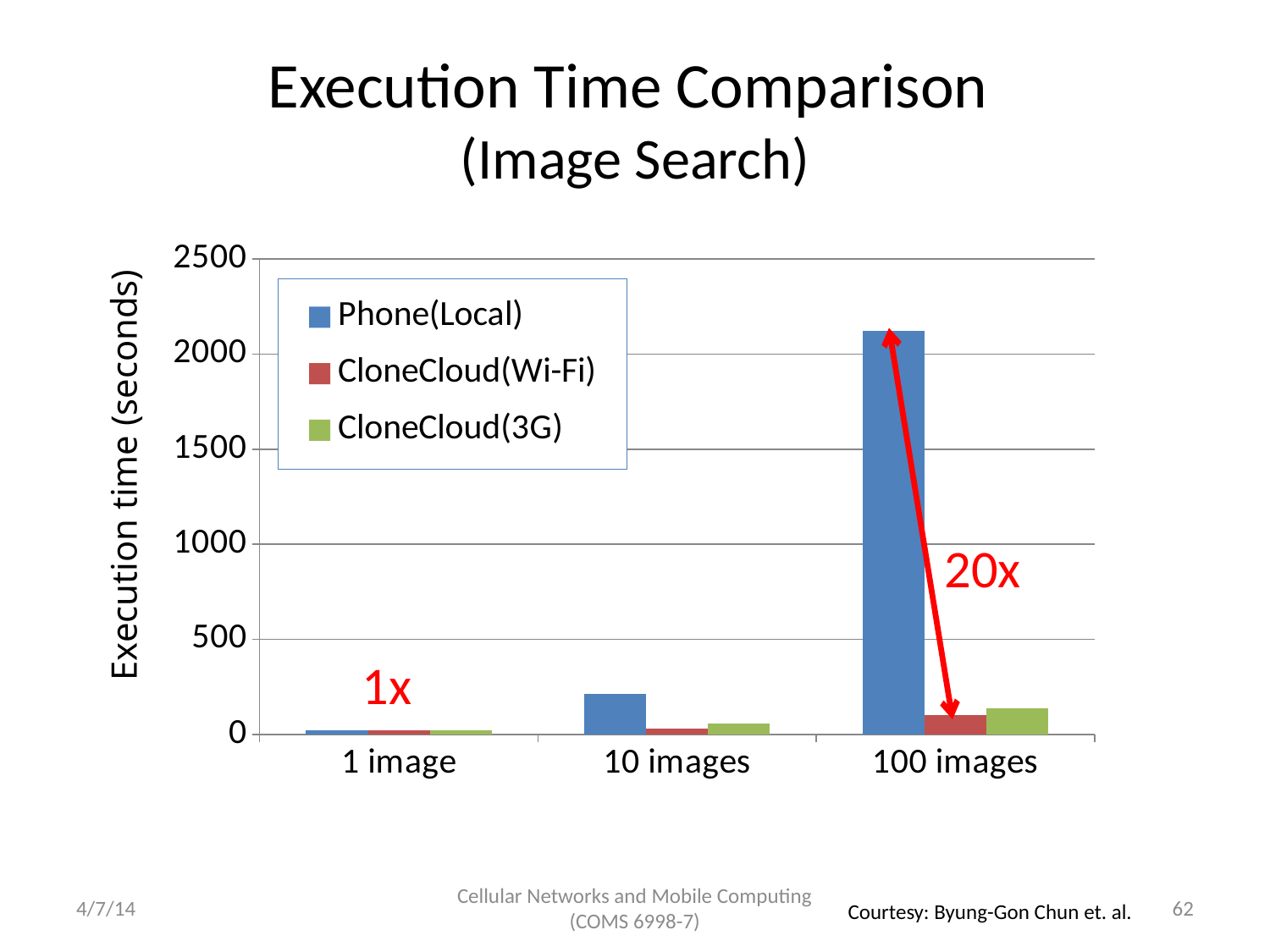
Which series has the lowest execution time for 100 images? CloneCloud(Wi-Fi) Which series has the highest execution time for 100 images? Phone(Local) Is the CloneCloud(3G) execution time for 100 images greater or less than 500? less What kind of chart is shown on the slide? bar chart Does the Phone(Local) execution time rise or fall as the number of images increases from 1 to 100? rise For 10 images, which is larger: the Phone(Local) execution time or the CloneCloud(3G) execution time? Phone(Local) Is the Phone(Local) execution time for 100 images greater or less than 2000? greater How many series does the legend list? 3 What speedup factor is annotated in red next to the 100 images bars? 20x How many categories are shown on the x axis? 3 What is the label on the y axis? Execution time (seconds) Is the Phone(Local) execution time for 10 images greater or less than 500? less